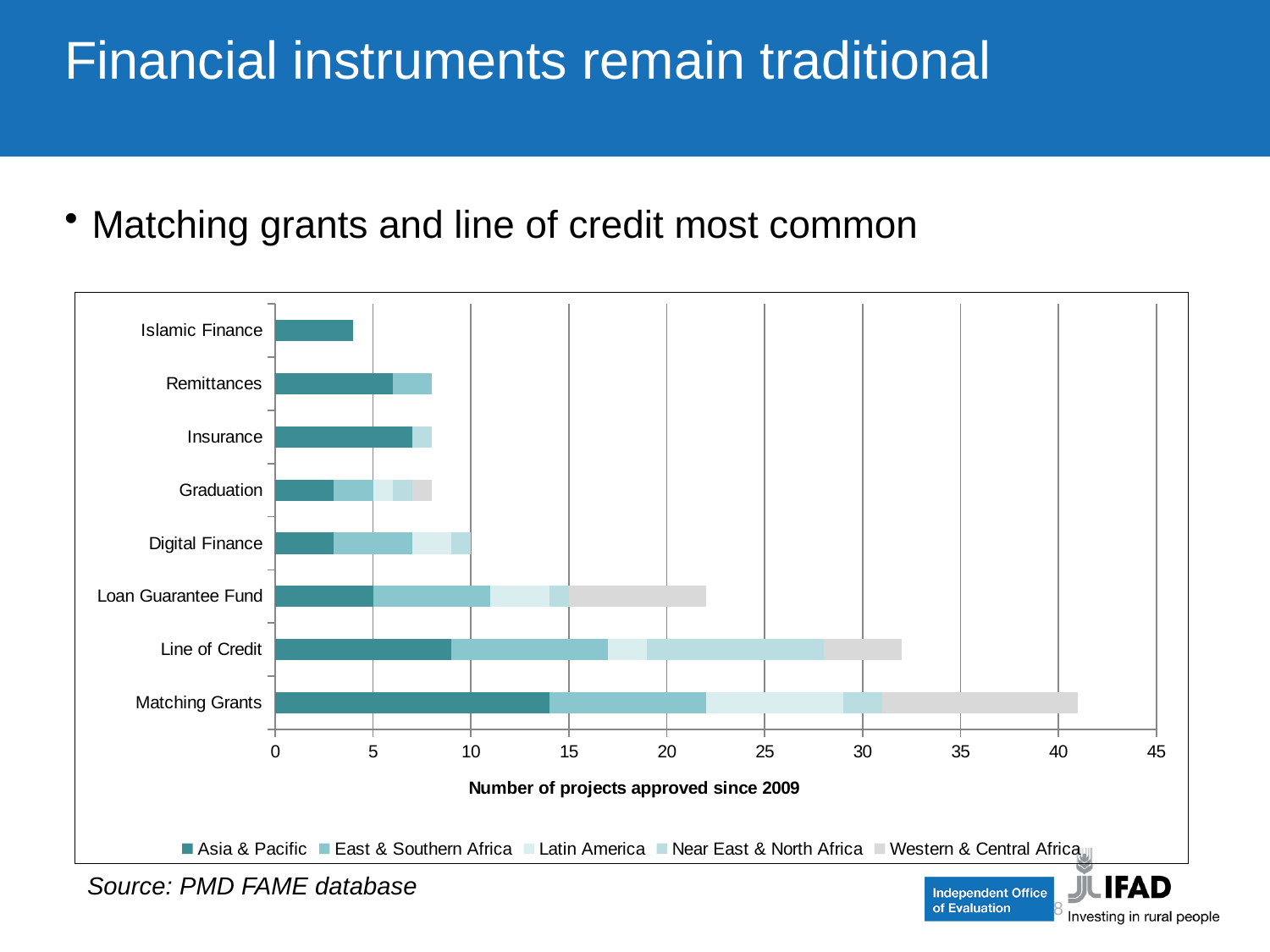
Is the total number of projects for Remittances greater or less than 10? less What is the title of the chart's horizontal axis? Number of projects approved since 2009 How many financial instrument categories are shown on the chart? 8 Which has a larger total number of projects: Line of Credit or Loan Guarantee Fund? Line of Credit Which region is listed first in the chart's legend? Asia & Pacific Which financial instrument has the highest total number of projects approved since 2009? Matching Grants How many series does the chart's legend list? 5 What kind of chart is shown on the slide? Stacked bar chart Which financial instrument has the lowest total number of projects approved since 2009? Islamic Finance Is the total number of projects for Line of Credit greater or less than 30? greater Is the total number of projects for Matching Grants greater or less than 35? greater